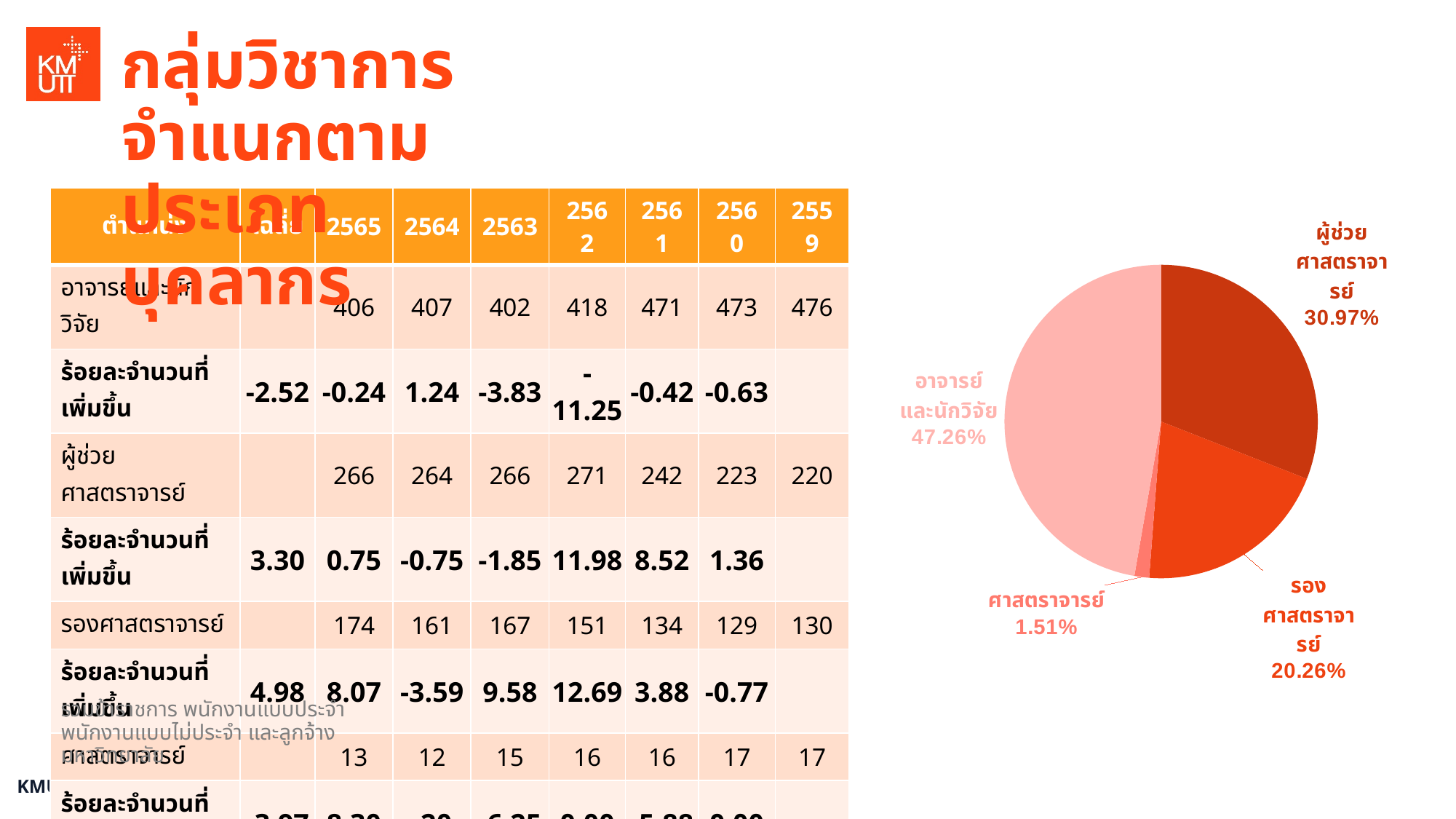
In the pie chart, what share is shown for ศาสตราจารย์? 1.51% In the pie chart, what is the difference between the share for อาจารย์และนักวิจัย and the share for ผู้ช่วยศาสตราจารย์? 16.29% In the pie chart, what share is shown for ผู้ช่วยศาสตราจารย์? 30.97% In the pie chart, what share is shown for อาจารย์และนักวิจัย? 47.26% How many slices does the pie chart have? 4 Which slice of the pie chart is the largest? อาจารย์และนักวิจัย In the pie chart, is the share for อาจารย์และนักวิจัย greater or less than 50%? less In the pie chart, which is larger: the share for ผู้ช่วยศาสตราจารย์ or the share for รองศาสตราจารย์? ผู้ช่วยศาสตราจารย์ In the pie chart, what share is shown for รองศาสตราจารย์? 20.26% In the pie chart, what is the difference between the share for รองศาสตราจารย์ and the share for ศาสตราจารย์? 18.75% Which slice of the pie chart is the smallest? ศาสตราจารย์ What kind of chart is shown on the right side of the slide? pie chart